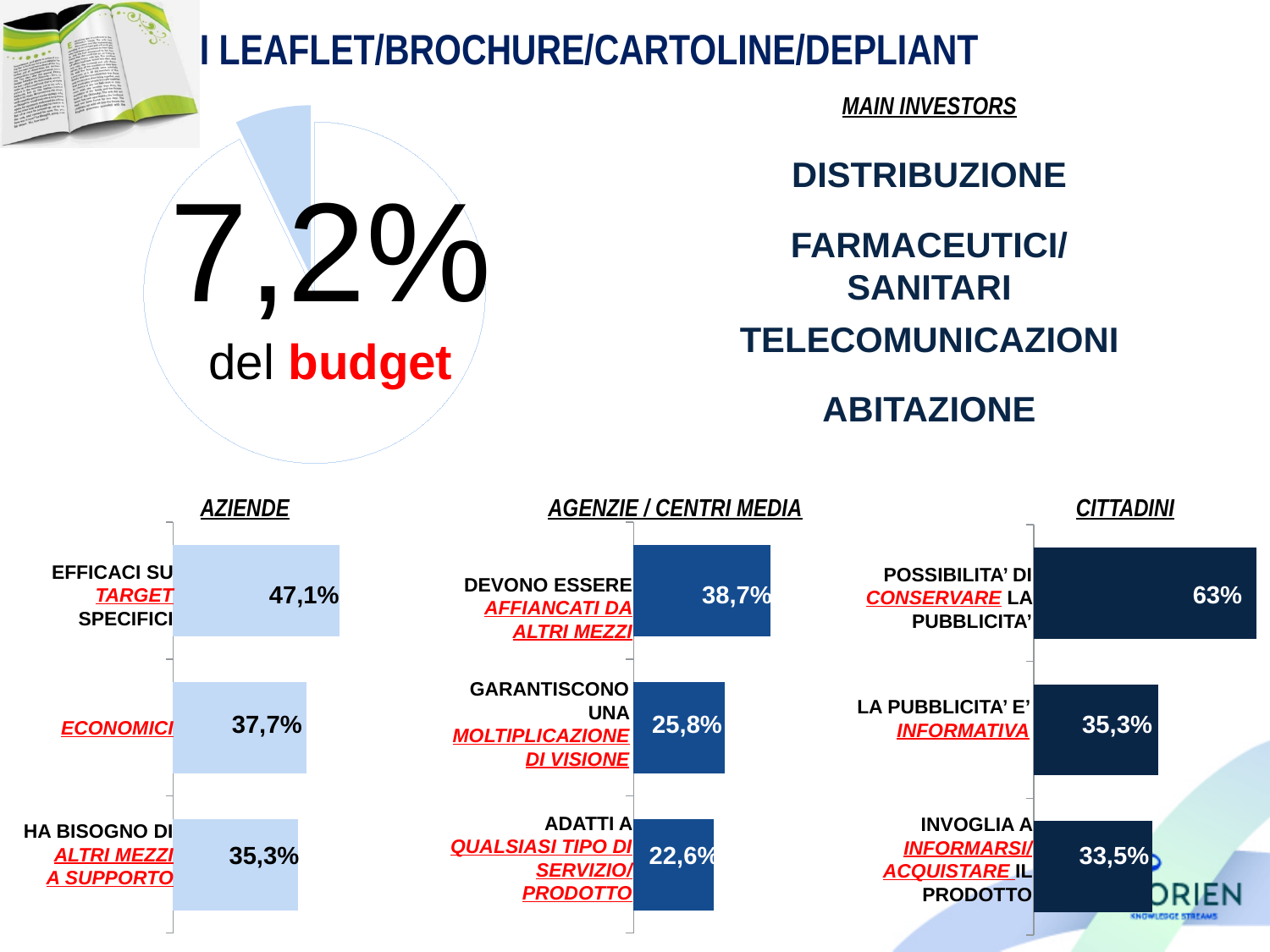
In the AZIENDE chart, what is the value for EFFICACI SU TARGET SPECIFICI? 47,1% What kind of chart is the AGENZIE / CENTRI MEDIA chart? Bar chart In the CITTADINI chart, what is the value for LA PUBBLICITA' E' INFORMATIVA? 35,3% In the CITTADINI chart, which category has the highest value? POSSIBILITA' DI CONSERVARE LA PUBBLICITA' How many categories does the AZIENDE chart show? 3 In the CITTADINI chart, what is the difference between POSSIBILITA' DI CONSERVARE LA PUBBLICITA' and INVOGLIA A INFORMARSI/ACQUISTARE IL PRODOTTO? 29,5% In the AZIENDE chart, what is the value for ECONOMICI? 37,7% In the AGENZIE / CENTRI MEDIA chart, which is larger: GARANTISCONO UNA MOLTIPLICAZIONE DI VISIONE or ADATTI A QUALSIASI TIPO DI SERVIZIO/PRODOTTO? GARANTISCONO UNA MOLTIPLICAZIONE DI VISIONE What share of the budget does the pie chart at the top left show for leaflets/brochures? 7,2% In the AZIENDE chart, what is the difference between EFFICACI SU TARGET SPECIFICI and HA BISOGNO DI ALTRI MEZZI A SUPPORTO? 11,8% In the AGENZIE / CENTRI MEDIA chart, which category has the lowest value? ADATTI A QUALSIASI TIPO DI SERVIZIO/PRODOTTO In the AGENZIE / CENTRI MEDIA chart, what is the value for DEVONO ESSERE AFFIANCATI DA ALTRI MEZZI? 38,7%